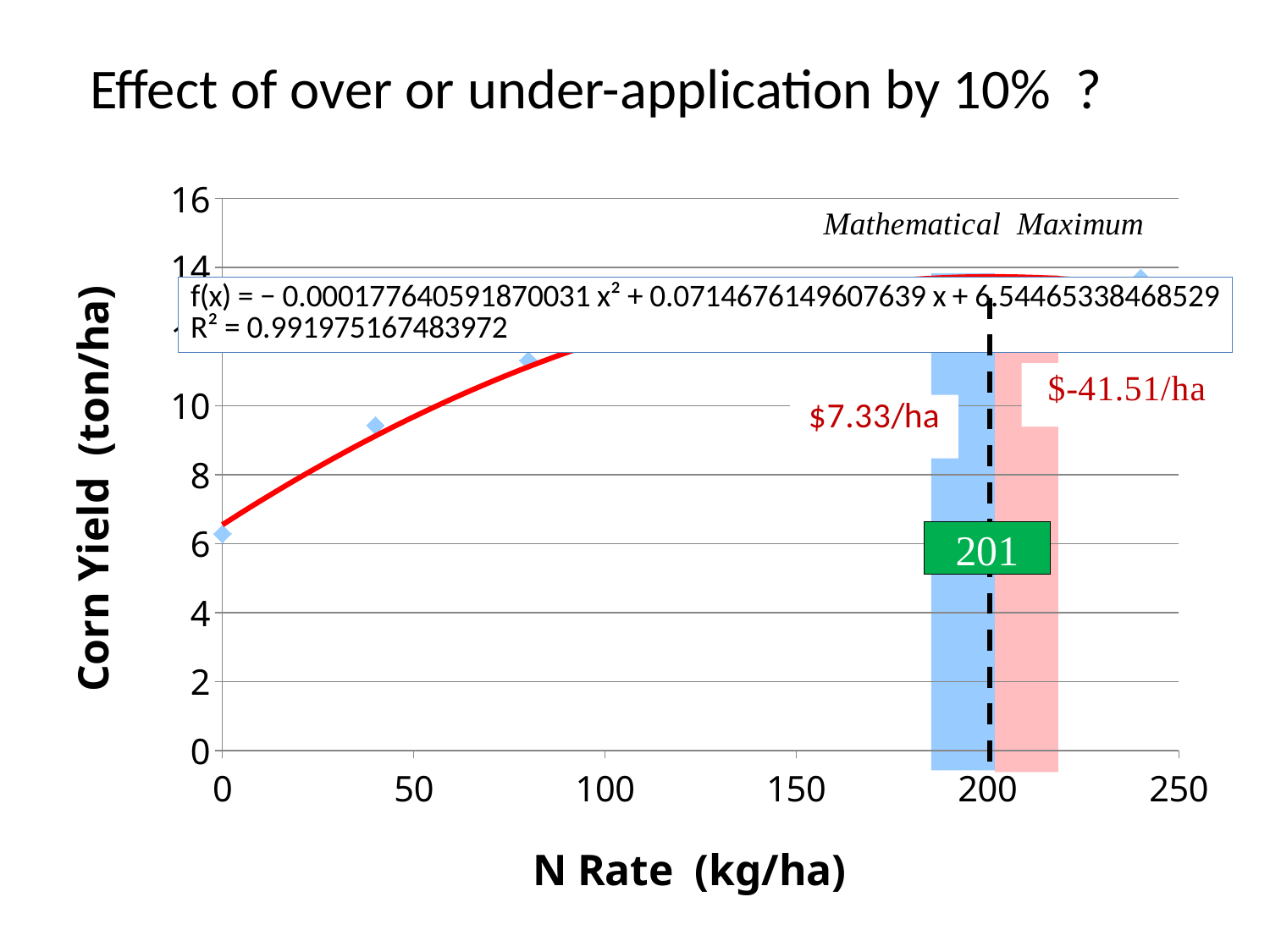
Is the corn yield at an N rate of 40 greater or less than 8 ton/ha? greater Is the corn yield at an N rate of 240 greater or less than 12 ton/ha? greater What kind of chart is shown on the slide? scatter chart with a fitted curve Is the corn yield at an N rate of 0 greater or less than 8 ton/ha? less What is the title of the y axis? Corn Yield (ton/ha) Which has the higher corn yield, an N rate of 40 or an N rate of 80? 80 Does corn yield rise or fall as N rate increases along the x axis? rise What is the title of the x axis? N Rate (kg/ha) What N rate is marked by the green label at the mathematical maximum? 201 What dollar value per hectare is shown in the red shaded region to the right of the dashed line? $-41.51/ha What R² value is shown for the fitted curve? 0.991975167483972